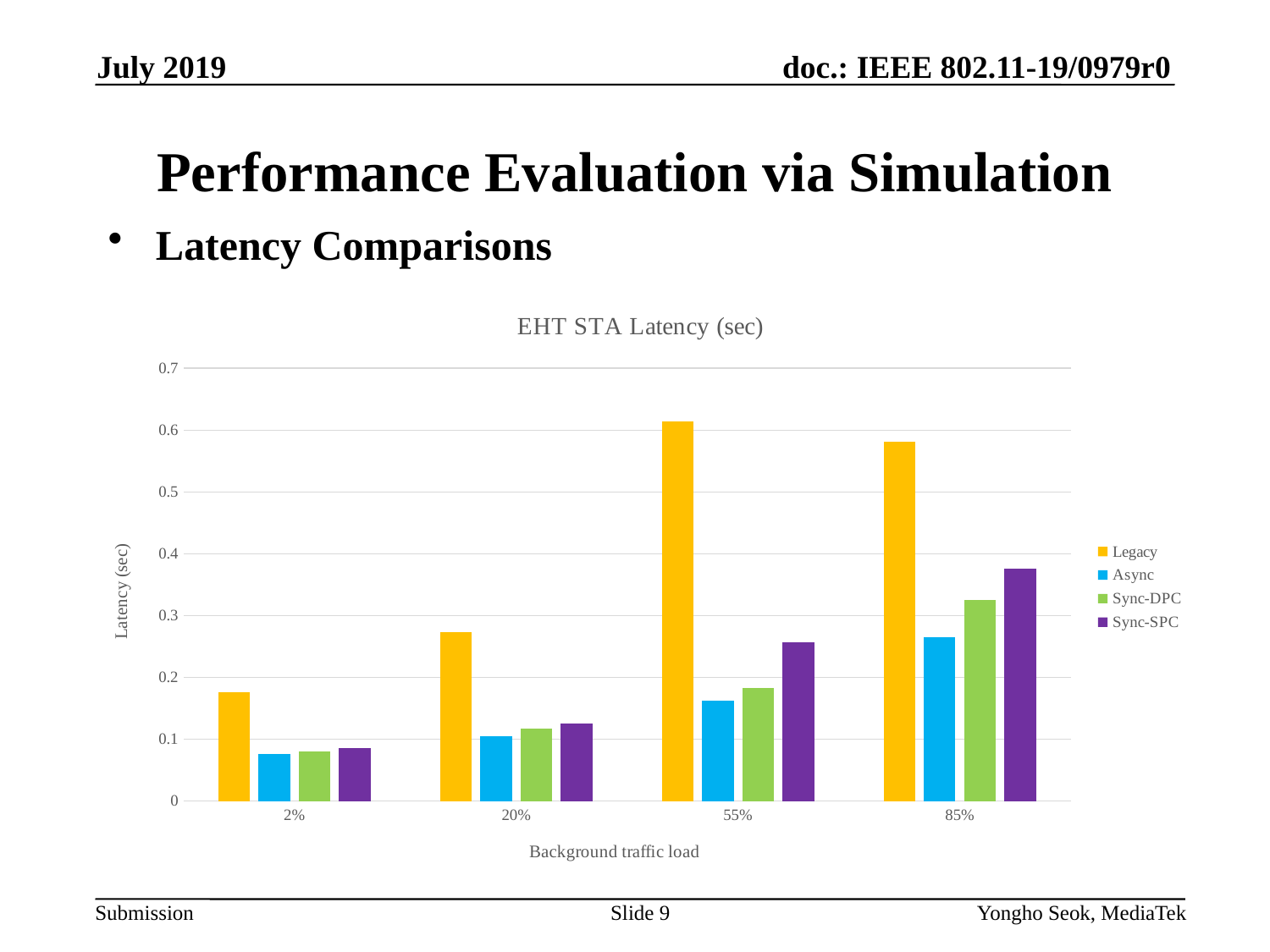
At 85% background traffic load, which has the larger latency, Async or Sync-SPC? Sync-SPC What kind of chart is shown on the slide? bar chart At which background traffic load is the Legacy latency highest? 55% Is the Legacy latency at 20% background traffic load greater or less than 0.3? less What is the title of the chart? EHT STA Latency (sec) Is the Legacy latency at 85% background traffic load greater or less than 0.6? less Which series has the lowest latency at 2% background traffic load? Async Is the Sync-SPC latency at 55% background traffic load greater or less than 0.2? greater How many background traffic load categories are shown on the x axis? 4 How many series does the legend list? 4 Does the Async latency rise or fall as background traffic load increases from 2% to 85%? rise